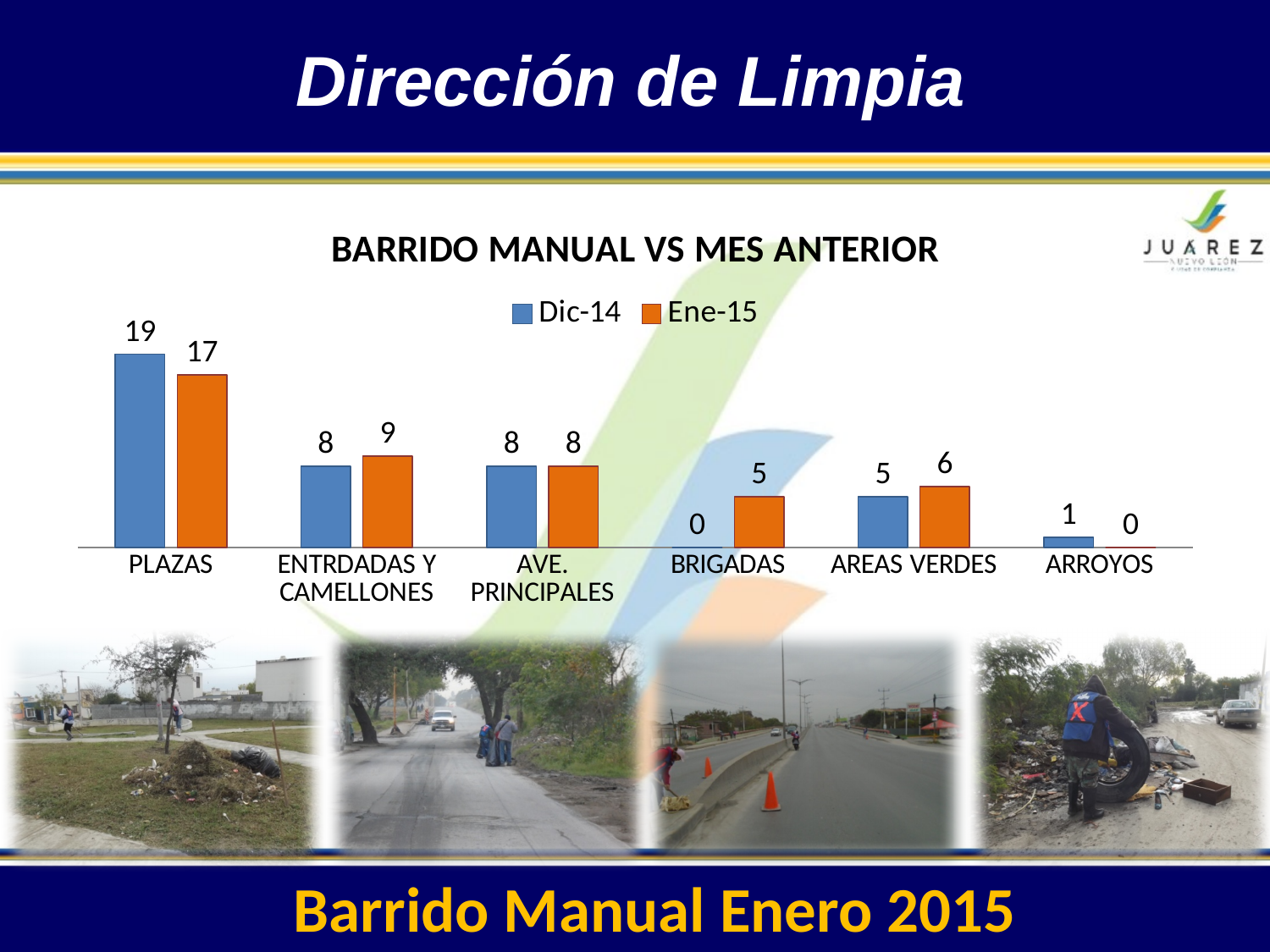
What is the difference between the Dic-14 and Ene-15 values for PLAZAS? 2 Which colour represents the Ene-15 series? Orange What is the title of the chart? BARRIDO MANUAL VS MES ANTERIOR What is the Ene-15 value for AREAS VERDES? 6 What is the Dic-14 value for PLAZAS? 19 How many categories are shown on the x axis? 6 How many series does the legend list? 2 What is the Ene-15 value for BRIGADAS? 5 Which is larger for ENTRDADAS Y CAMELLONES, the Dic-14 value or the Ene-15 value? Ene-15 Which category has the highest Ene-15 value? PLAZAS What kind of chart is shown? Bar chart Which category has the lowest Dic-14 value? BRIGADAS